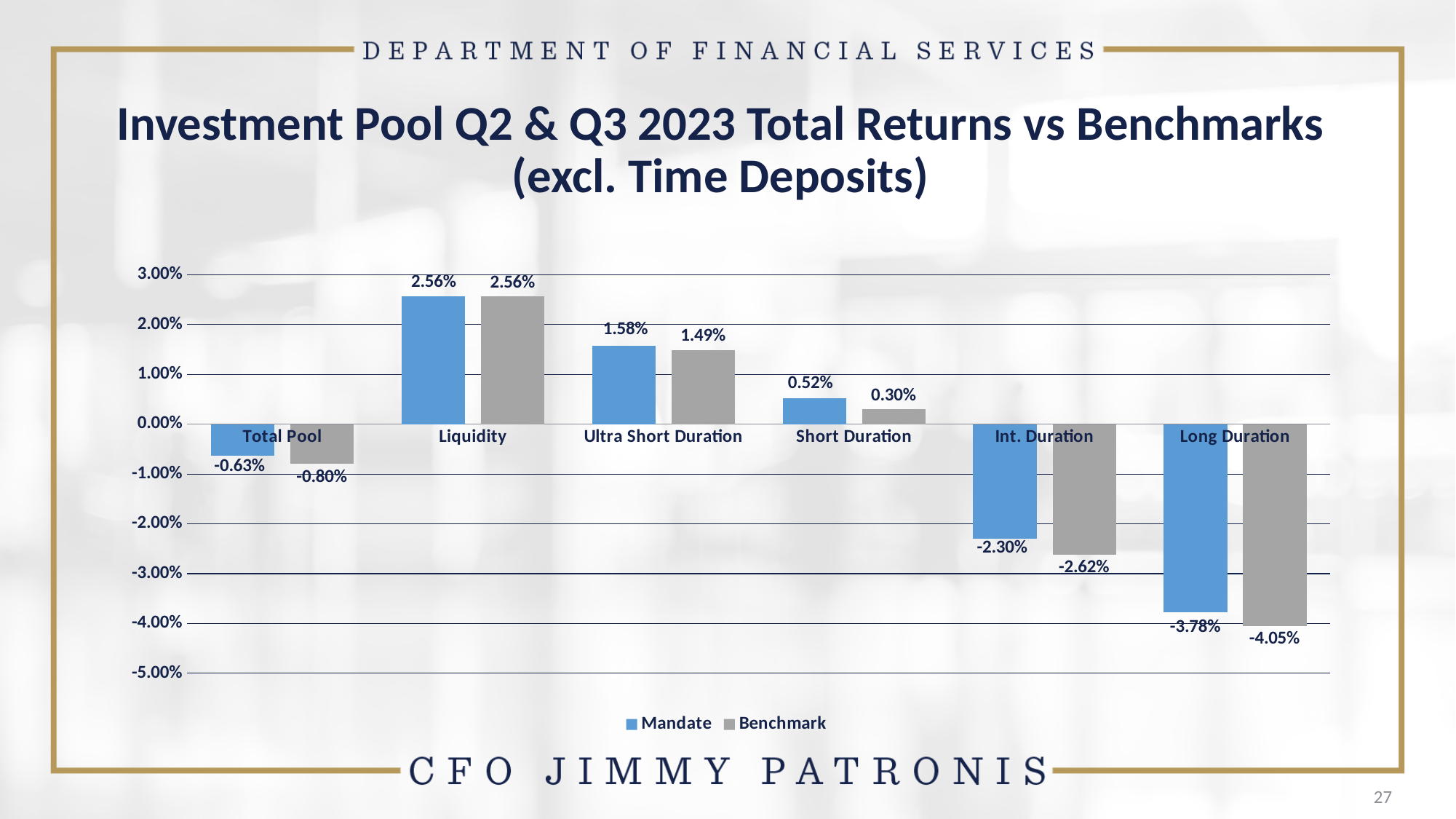
How many categories are shown on the x axis? 6 How many series does the legend list? 2 What is the Benchmark value for Long Duration? -4.05% What is the Benchmark value for Short Duration? 0.30% Which category has the highest Mandate value? Liquidity Which category has the lowest Benchmark value? Long Duration What is the Mandate value for Ultra Short Duration? 1.58% What is the difference between the Mandate and Benchmark values for Int. Duration? 0.32% Which colour represents the Benchmark series? Gray Which is larger for Short Duration, the Mandate value or the Benchmark value? Mandate What kind of chart is shown on the slide? Bar chart What is the Mandate value for Total Pool? -0.63%